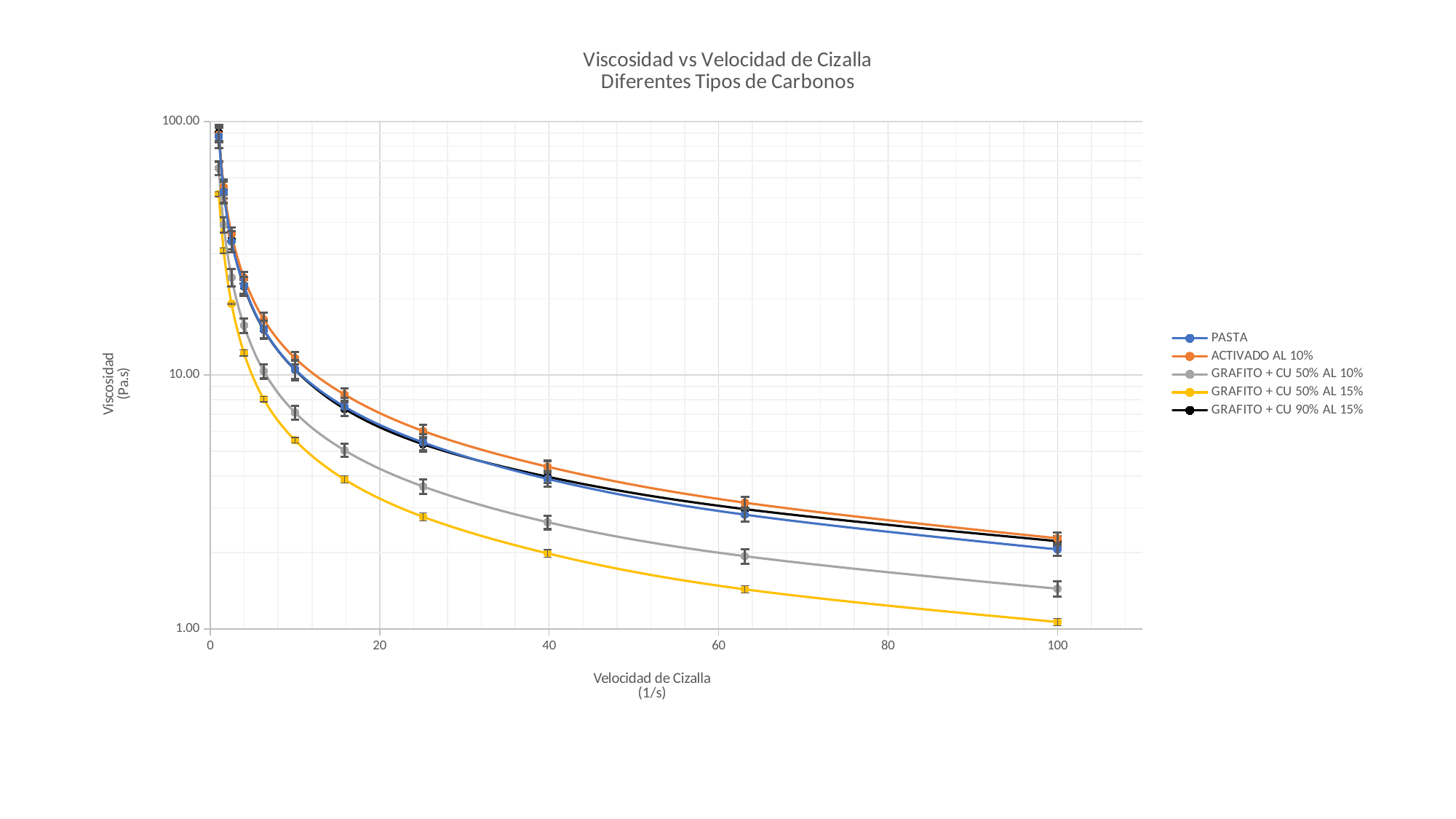
Is the viscosity of GRAFITO + CU 50% AL 15% at a shear rate of 40 1/s greater or less than 10.00? less What kind of chart is shown on the slide? line chart What is the title of the chart? Viscosidad vs Velocidad de Cizalla Diferentes Tipos de Carbonos At a shear rate of 100 1/s, which is larger: the viscosity of PASTA or of GRAFITO + CU 50% AL 10%? PASTA What is the label of the y axis? Viscosidad (Pa.s) How many series does the legend list? 5 Is the viscosity of GRAFITO + CU 50% AL 10% at a shear rate of 60 1/s greater or less than 1.00? greater Is the viscosity of PASTA at a shear rate of 100 1/s greater or less than 10.00? less Which series has the lowest viscosity at a shear rate of 100 1/s? GRAFITO + CU 50% AL 15% At a shear rate of 100 1/s, which is larger: the viscosity of ACTIVADO AL 10% or of GRAFITO + CU 50% AL 15%? ACTIVADO AL 10% Do the viscosity values rise or fall as the shear rate (Velocidad de Cizalla) increases? fall